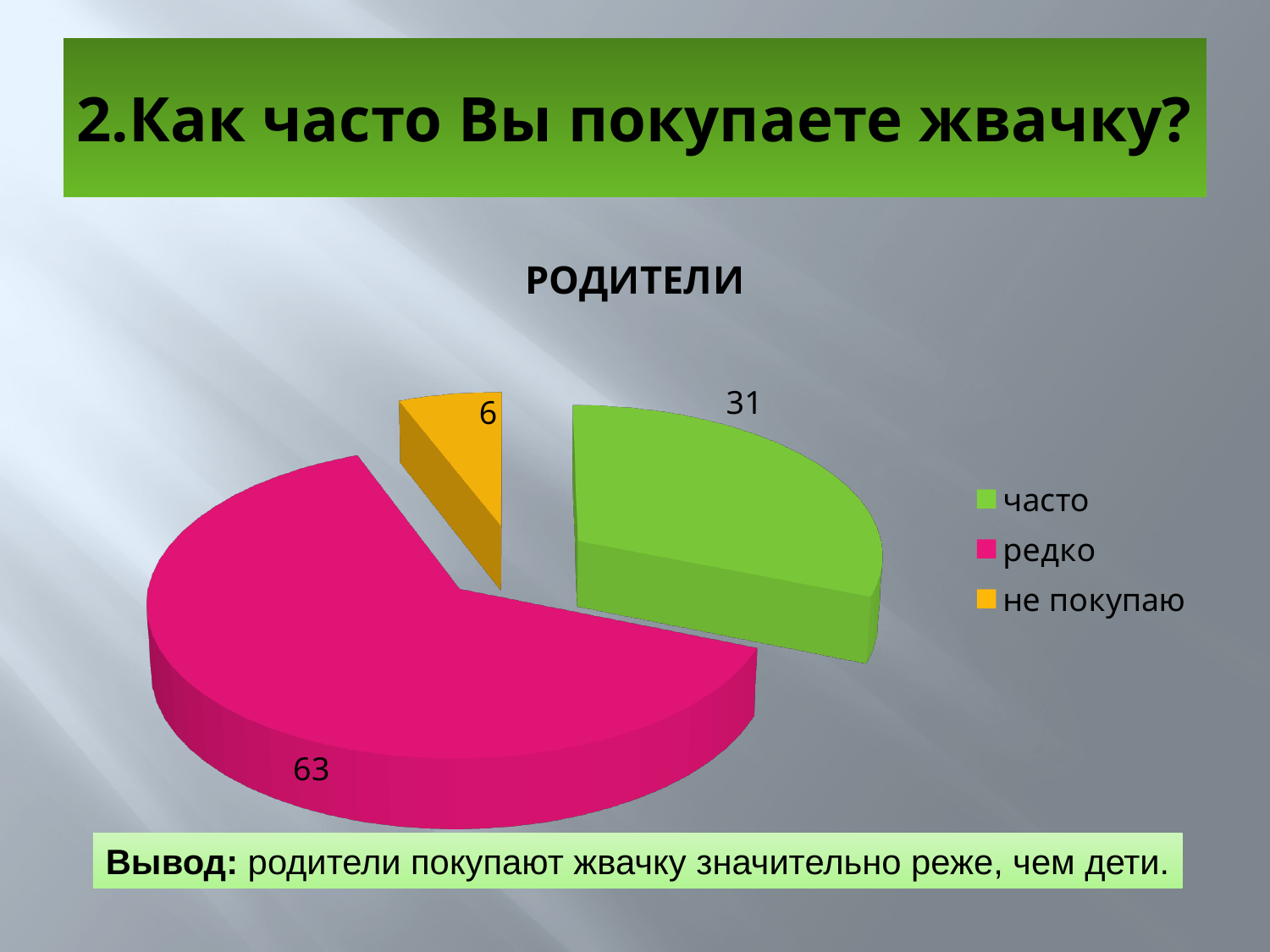
What is the difference between the values for 'редко' and 'часто'? 32 What is the value for the 'часто' slice? 31 What share of the pie does the 'редко' slice represent? 63% What colour is the 'не покупаю' slice? orange What is the value for the 'не покупаю' slice? 6 How many slices does the pie chart have? 3 What is the value for the 'редко' slice? 63 What type of chart is shown on the slide? pie chart Which category has the largest slice? редко Which category has the smallest slice? не покупаю What is the title of the chart? РОДИТЕЛИ Which is larger, the value for 'часто' or the value for 'не покупаю'? часто